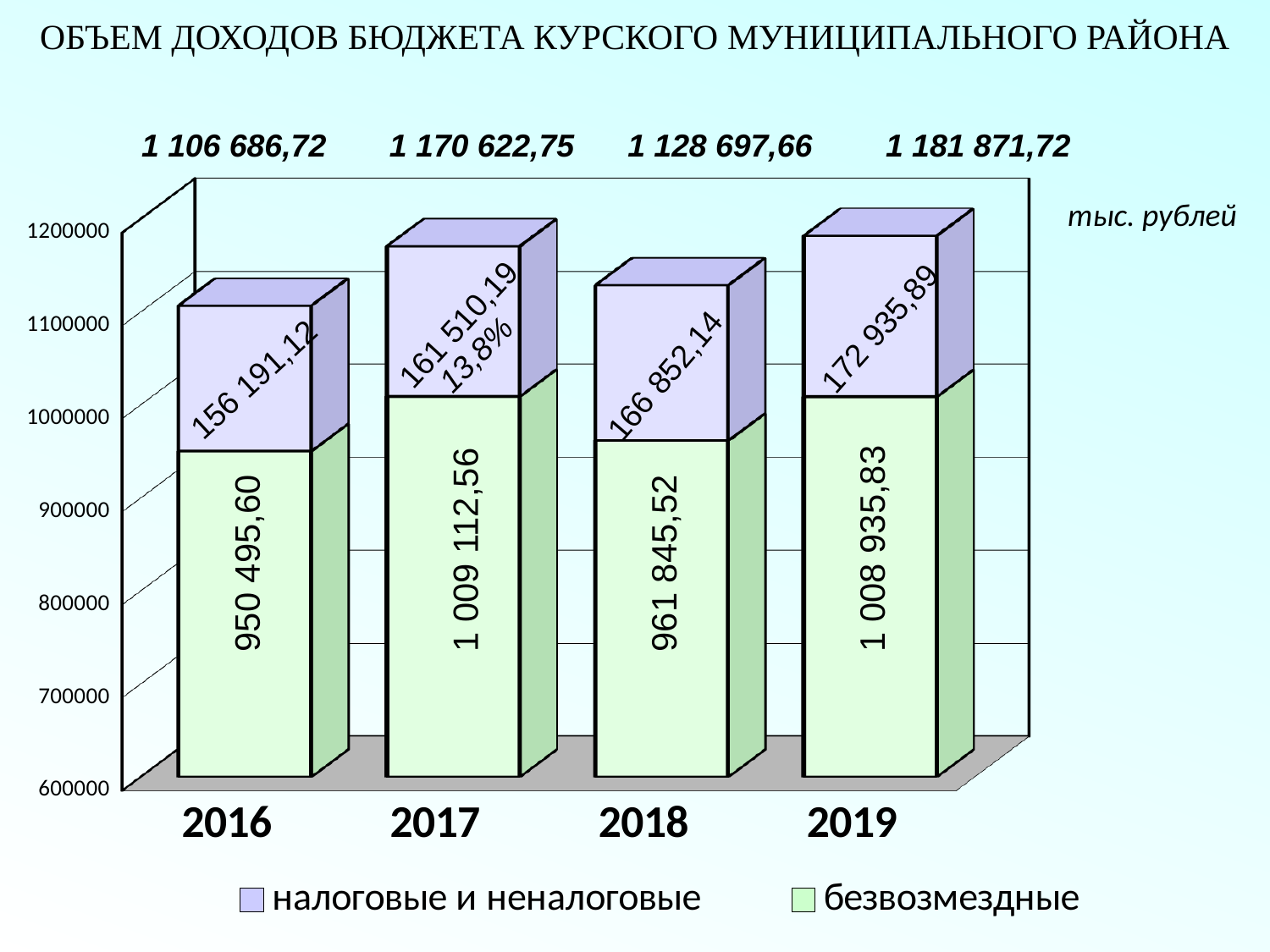
What is the total of the stacked bar for 2019? 1 181 871,72 What is the total of the stacked bar for 2018? 1 128 697,66 How many years are shown on the x axis? 4 What is the value of безвозмездные for 2017? 1 009 112,56 What is the value of безвозмездные for 2018? 961 845,52 How many series does the legend list? 2 Which year has the lowest value for безвозмездные? 2016 What is the value of налоговые и неналоговые for 2016? 156 191,12 Which year has the highest value for налоговые и неналоговые? 2019 Is the value of безвозмездные for 2019 larger than for 2018? Yes What kind of chart is shown on the slide? Stacked bar chart What is the value of налоговые и неналоговые for 2019? 172 935,89